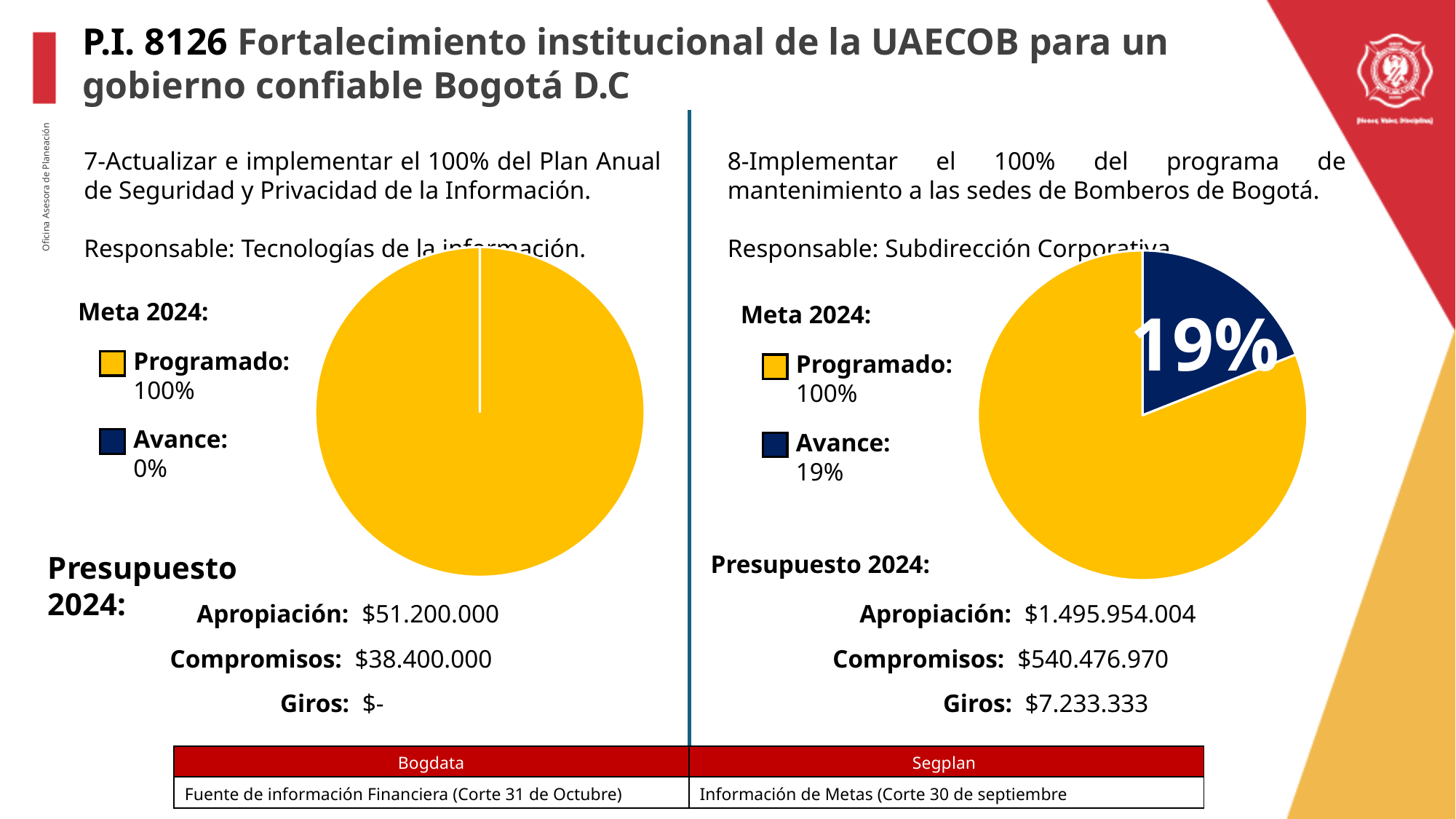
How many entries does the legend of the right chart (goal 8) list? 2 In the left chart (goal 7), what is the difference between Programado and Avance? 100% What kind of chart is shown on the right side of the slide (goal 8)? pie chart In the right chart (goal 8), what is the difference between Programado and Avance? 81% What colour represents Avance in the legends of the charts? dark blue How many pie charts are shown on the slide? 2 In the right chart (goal 8), what is the value for Avance? 19% In the left chart (goal 7), what is the value for Programado? 100% What percentage label is printed on the dark blue slice of the right chart (goal 8)? 19% In the right chart (goal 8), what is the value for Programado? 100% In the left chart (goal 7), what is the value for Avance? 0% In the right chart (goal 8), which is larger, Programado or Avance? Programado